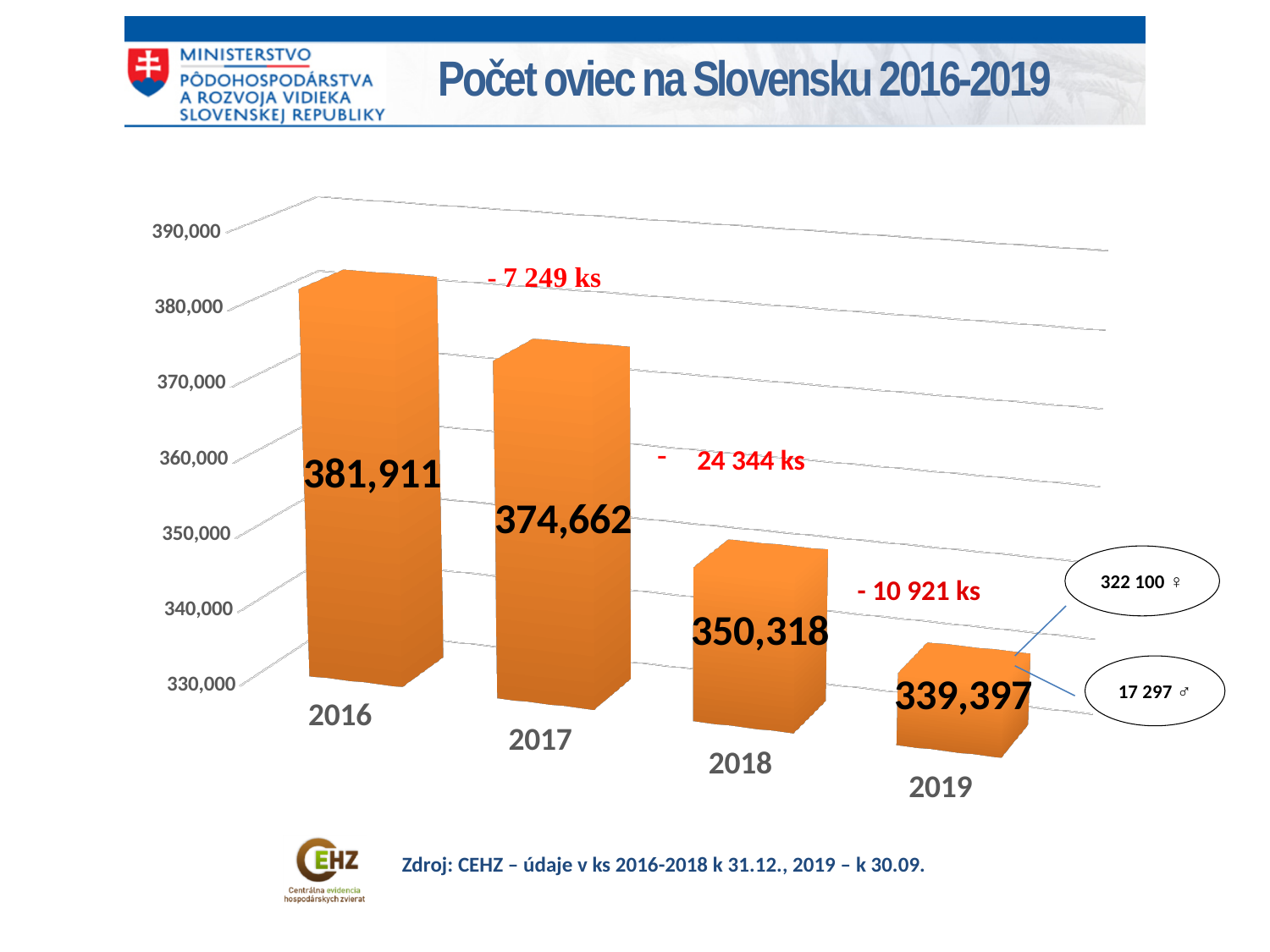
What is the number of sheep shown for 2017? 374,662 Which year has the highest number of sheep? 2016 Which is larger, the value for 2018 or the value for 2019? 2018 What kind of chart is shown on the slide? Bar chart What is the number of sheep shown for 2018? 350,318 What is the number of sheep shown for 2016? 381,911 Which year has the lowest number of sheep? 2019 What is the difference between the 2016 and 2017 values? 7,249 How many years are plotted on the chart? 4 Do the values rise or fall from 2016 to 2019? Fall What is the number of sheep shown for 2019? 339,397 What is the difference between the 2017 and 2018 values? 24,344